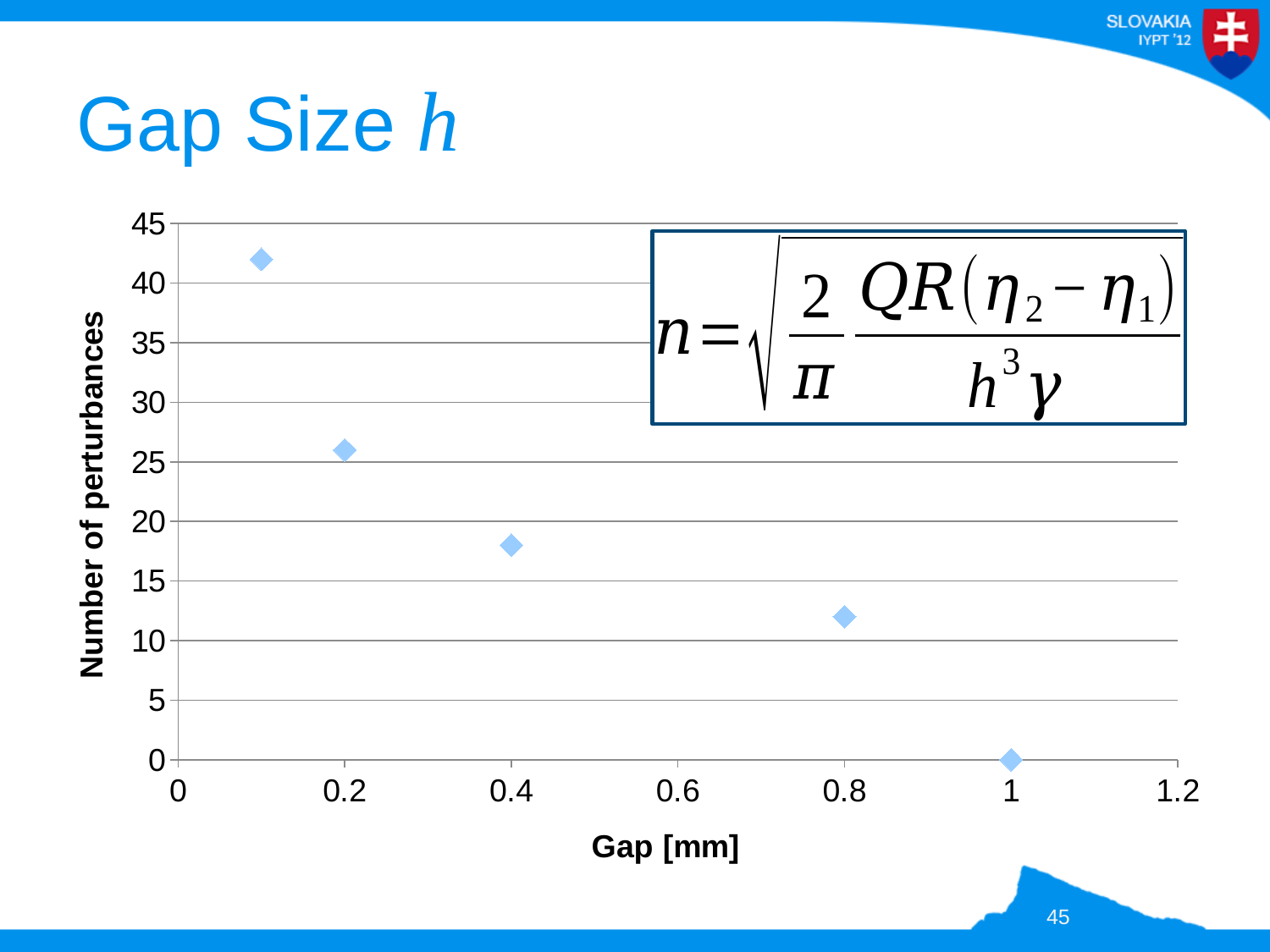
Is the number of perturbances at a gap of 0.4 mm greater or less than 20? less Is the number of perturbances at a gap of 0.2 mm greater or less than 25? greater What kind of chart is shown on the slide? scatter chart What is the label of the x axis? Gap [mm] Does the number of perturbances rise or fall as the gap increases along the x axis? fall What is the number of perturbances at a gap of 1 mm? 0 Which has more perturbances: the point at a gap of 0.2 mm or the point at 0.8 mm? 0.2 mm How many data points are plotted on the chart? 5 At which gap value is the number of perturbances lowest? 1 mm Is the number of perturbances for the leftmost point greater or less than 40? greater